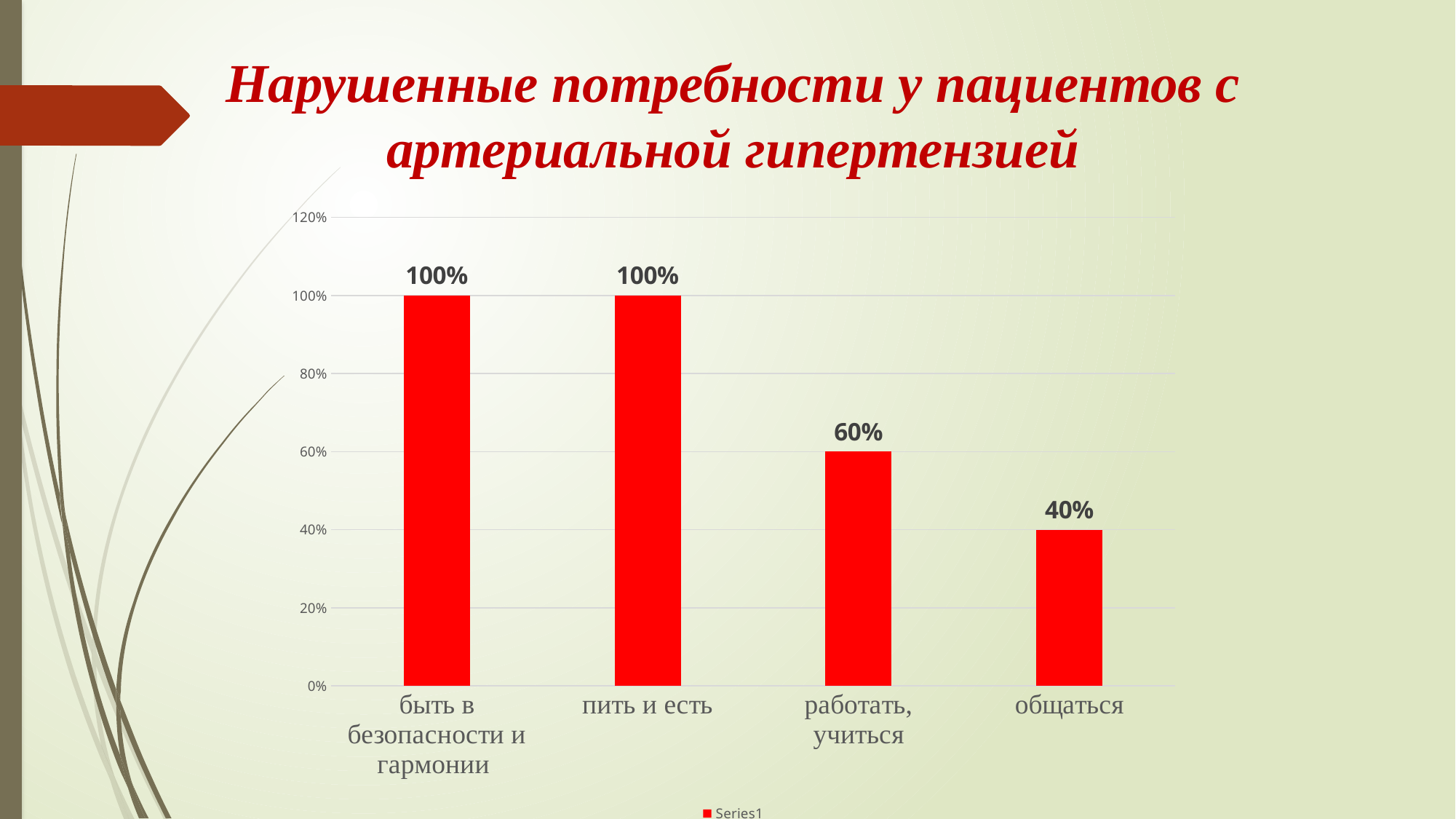
What kind of chart is shown on the slide? bar chart Which is larger, the value for "работать, учиться" or the value for "общаться"? работать, учиться What is the value for "работать, учиться"? 60% What is the difference between the values for "работать, учиться" and "общаться"? 20% Which category has the lowest value? общаться What is the value for "быть в безопасности и гармонии"? 100% How many categories are shown on the x axis? 4 How many series does the legend list? 1 What is the title of the slide? Нарушенные потребности у пациентов с артериальной гипертензией What is the value for "общаться"? 40% What is the difference between the values for "пить и есть" and "работать, учиться"? 40% What is the value for "пить и есть"? 100%